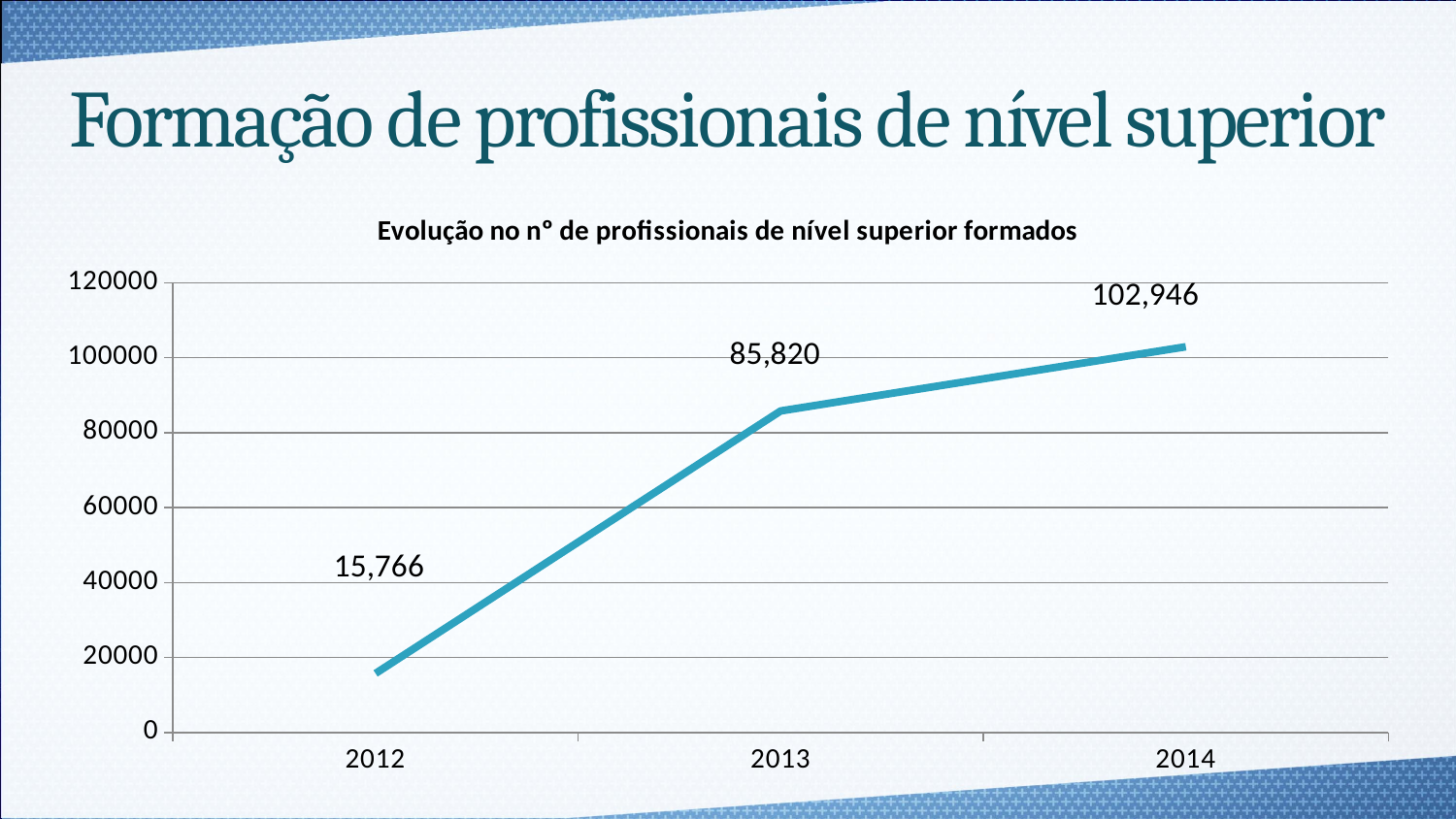
What is the value for 2012? 15,766 How many years are plotted on the chart? 3 What is the value for 2013? 85,820 Which year has the highest value? 2014 What is the difference between the values for 2013 and 2012? 70,054 What is the value for 2014? 102,946 Do the values rise or fall from 2012 to 2014? rise Which is larger, the value for 2013 or the value for 2014? 2014 Is the value for 2014 greater or less than 100000? greater What kind of chart is shown on the slide? line chart What is the difference between the values for 2014 and 2013? 17,126 Which year has the lowest value? 2012